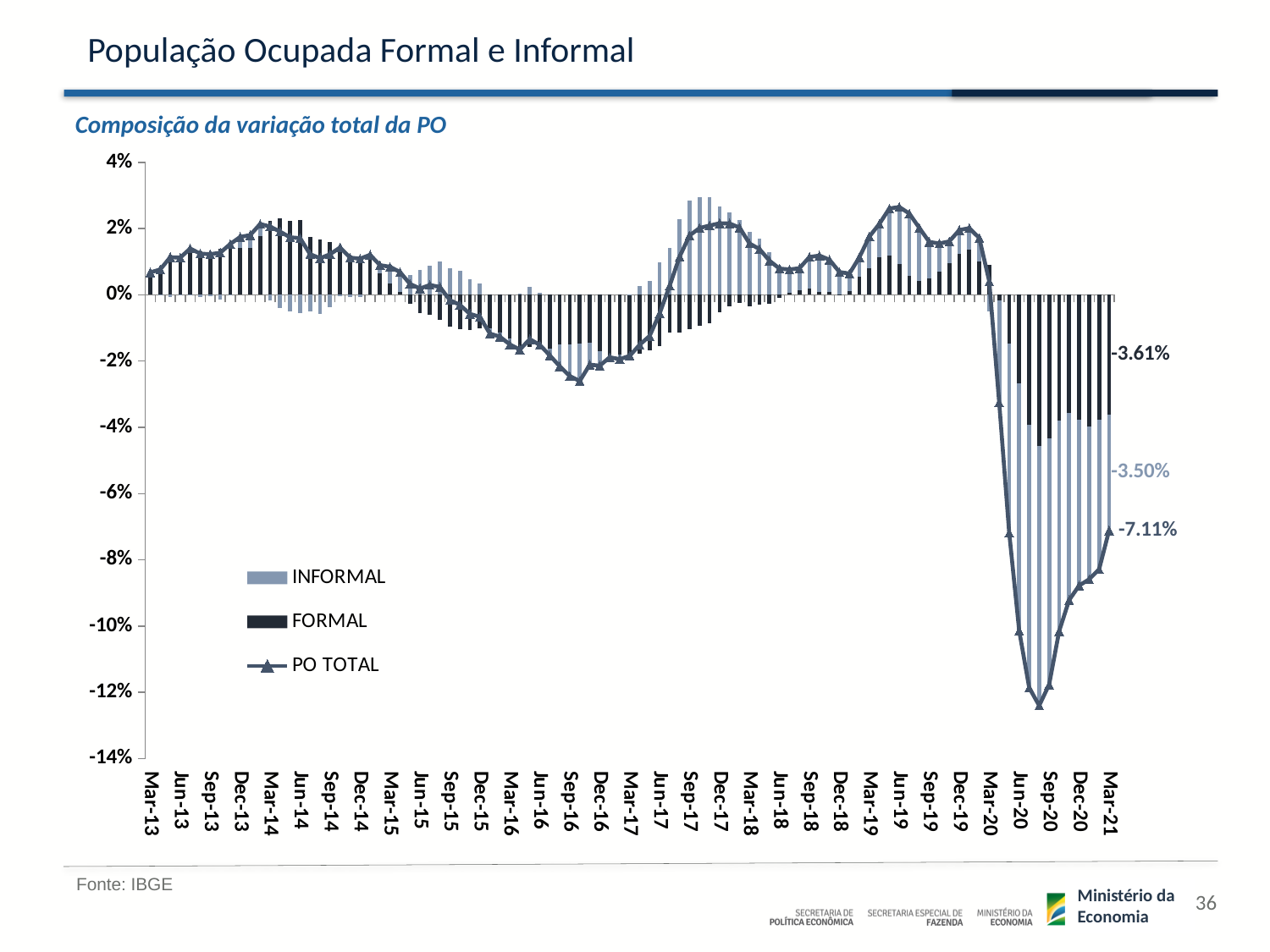
Does the PO TOTAL line rise or fall between Mar-20 and Sep-20? fall At which date does the PO TOTAL line reach its lowest point? Aug-20 Is the value of PO TOTAL at Jun-19 greater or less than 2%? greater What is the value of PO TOTAL at Mar-21? -7.11% Is the value of PO TOTAL at Sep-20 greater or less than -10%? less At Mar-21, which is larger (less negative): the FORMAL value or the INFORMAL value? INFORMAL What is the subtitle of the chart? Composição da variação total da PO How many series does the legend list? 3 What is the value of the INFORMAL series at Mar-21? -3.50% What is the difference between the FORMAL value (-3.61%) and the INFORMAL value (-3.50%) at Mar-21? 0.11 percentage points What is the value of the FORMAL series at Mar-21? -3.61% What kind of chart is shown on the slide? Combined stacked bar and line chart